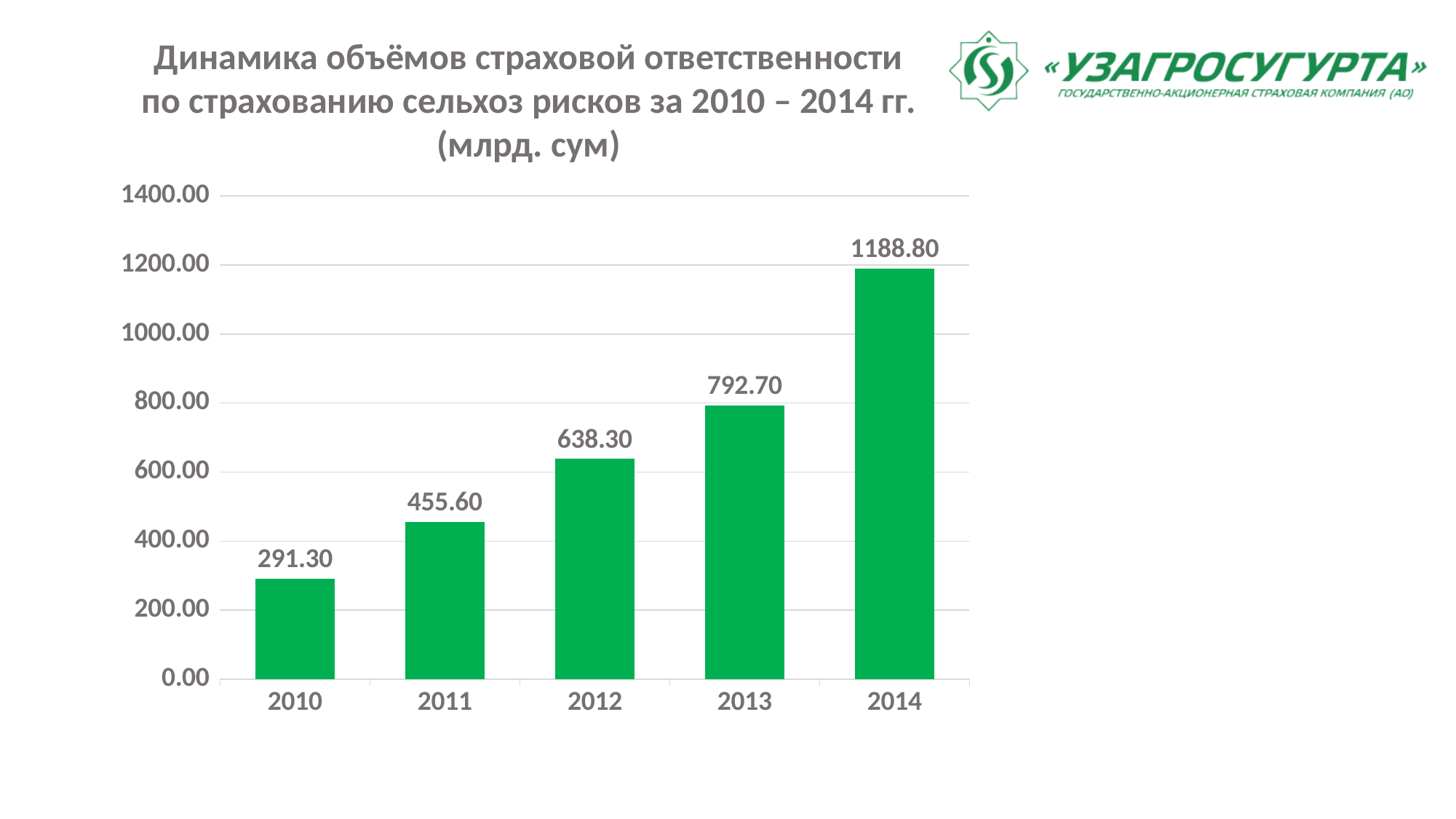
What is the difference between the values for 2011 and 2010? 164.30 Do the values rise or fall from 2010 to 2014? rise What kind of chart is shown on the slide? bar chart What is the value for 2012? 638.30 Which is larger, the value for 2012 or the value for 2013? 2013 What is the value for 2014? 1188.80 How many years are shown on the x axis? 5 What is the value for 2010? 291.30 Which year has the lowest value? 2010 What is the difference between the values for 2014 and 2013? 396.10 Is the value for 2013 greater or less than 800.00? less Which year has the highest value? 2014